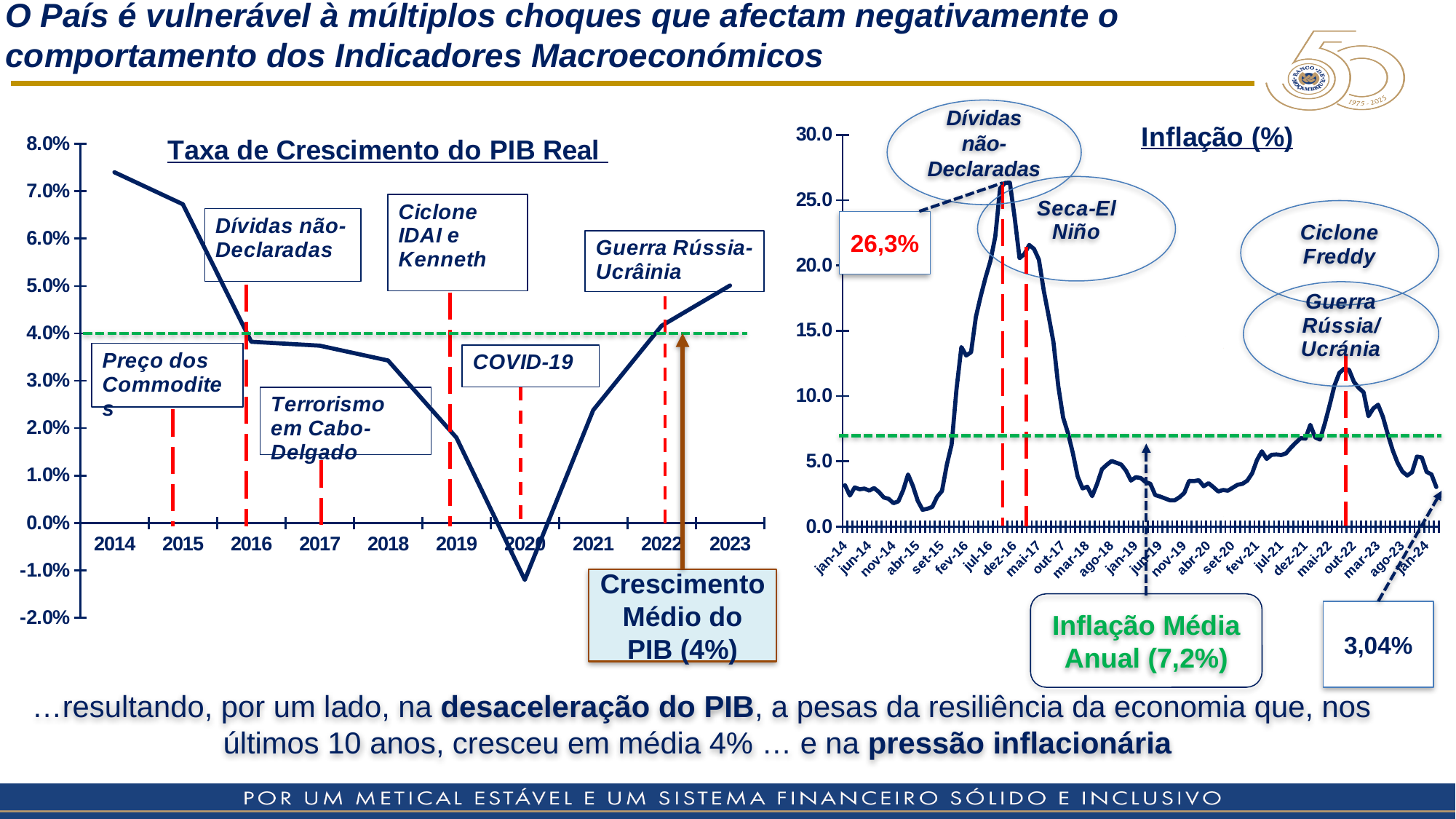
In the 'Taxa de Crescimento do PIB Real' chart, do the values rise or fall from 2014 to 2020? fall In the 'Taxa de Crescimento do PIB Real' chart, which year has the lowest GDP growth rate? 2020 In the 'Taxa de Crescimento do PIB Real' chart, is the value for 2020 greater or less than 0.0%? less In the 'Inflação (%)' chart, is the value for out-22 greater or less than 10.0? greater What kind of chart is the 'Taxa de Crescimento do PIB Real' chart? line chart In the 'Inflação (%)' chart, what inflation value is labelled for jan-24? 3,04% In the 'Taxa de Crescimento do PIB Real' chart, which year has the highest GDP growth rate? 2014 In the 'Inflação (%)' chart, what is the peak inflation value labelled on the chart? 26,3% In the 'Inflação (%)' chart, what is the annual average inflation stated in the annotation box? 7,2% In the 'Taxa de Crescimento do PIB Real' chart, is the value for 2014 greater or less than 7.0%? greater In the 'Taxa de Crescimento do PIB Real' chart, what average GDP growth is stated in the annotation box? 4% In the 'Taxa de Crescimento do PIB Real' chart, how many years are shown on the x axis? 10